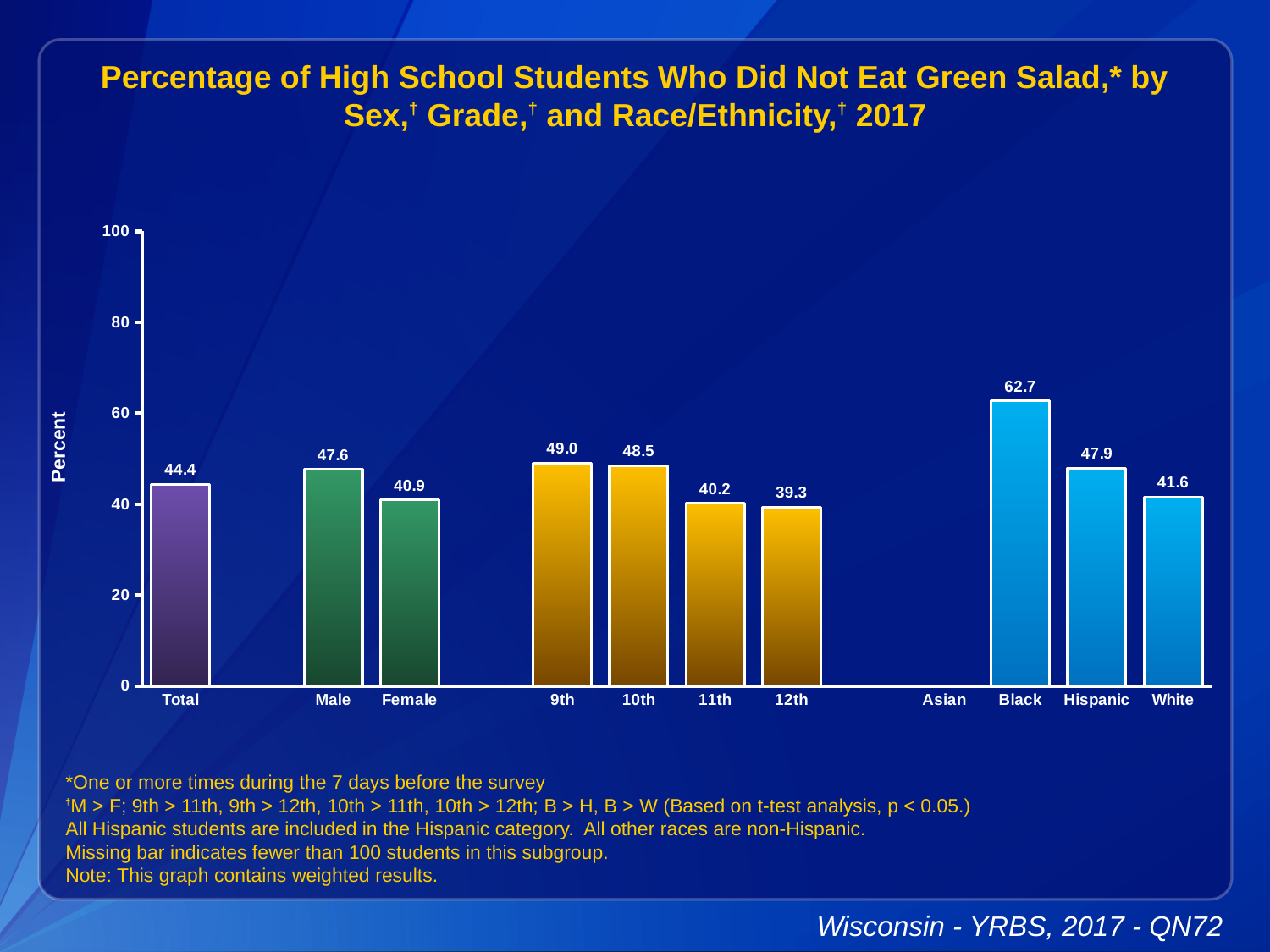
What is the value for Total? 44.4 Which is larger, the value for Black or the value for White? Black Is the value for 9th grade greater or less than 40? greater What is the value for 12th grade? 39.3 How many bars are plotted on the chart? 10 Do the values rise or fall from 9th grade to 12th grade? fall Which category has the highest value? Black Which category has the lowest plotted value? 12th What kind of chart is shown? bar chart What is the value for Female? 40.9 What is the difference between the values for Male and Female? 6.7 Which category label has no bar plotted? Asian